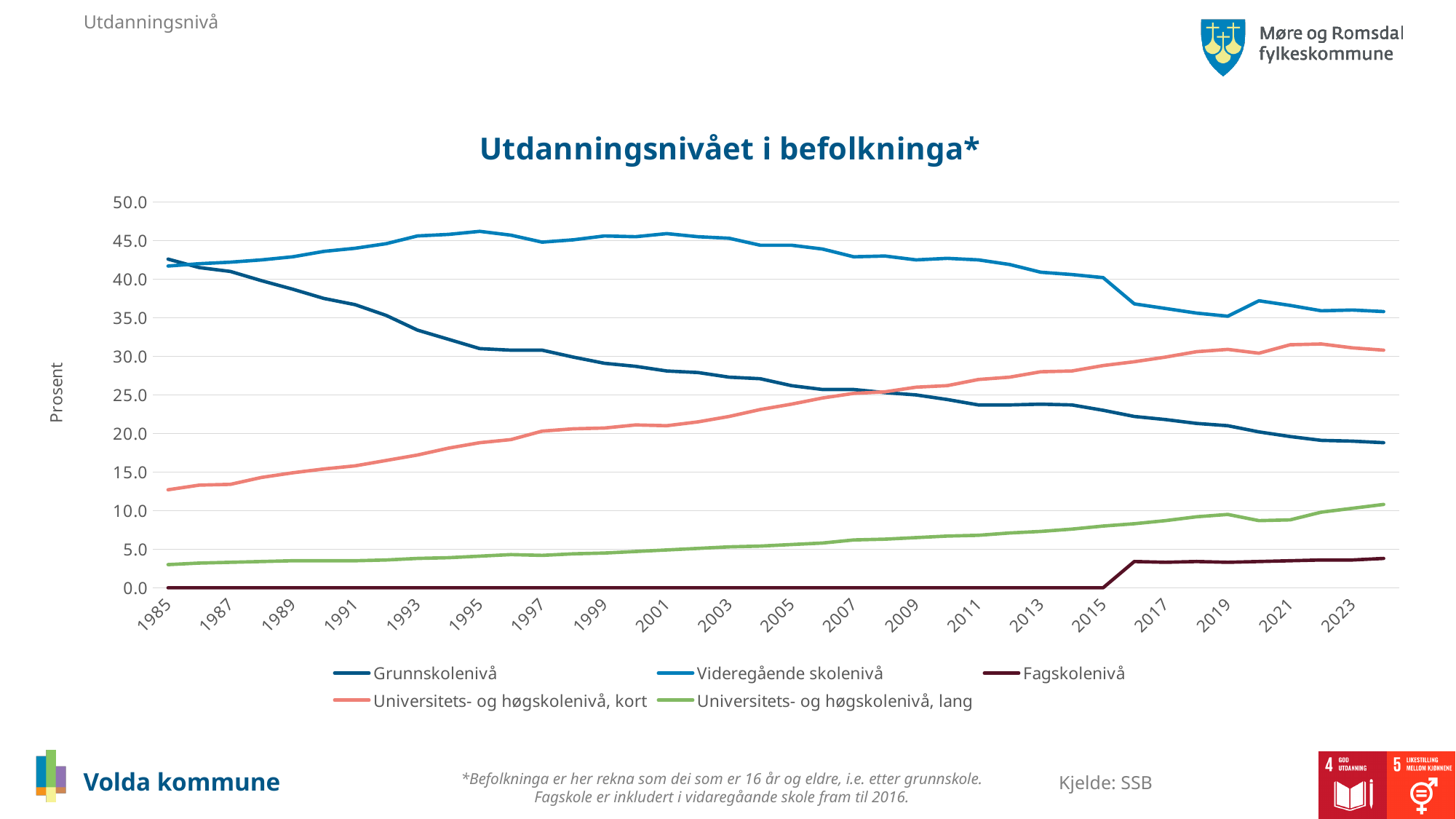
What is the title of the chart? Utdanningsnivået i befolkninga* Does the Grunnskolenivå line rise or fall from 1985 to 2023? Fall In 2023, which is higher: Grunnskolenivå or Universitets- og høgskolenivå, kort? Universitets- og høgskolenivå, kort Does the Universitets- og høgskolenivå, kort line rise or fall from 1985 to 2023? Rise Is the value for Videregående skolenivå in 1995 greater or less than 45.0? greater Which series has the highest value in 2023? Videregående skolenivå What is the label on the vertical axis? Prosent Is the value for Grunnskolenivå in 2023 greater or less than 20.0? less What is the value for Fagskolenivå in 2010? 0.0 Is the value for Universitets- og høgskolenivå, kort in 1985 greater or less than 15.0? less What kind of chart is shown on the slide? Line chart How many series does the legend list? 5